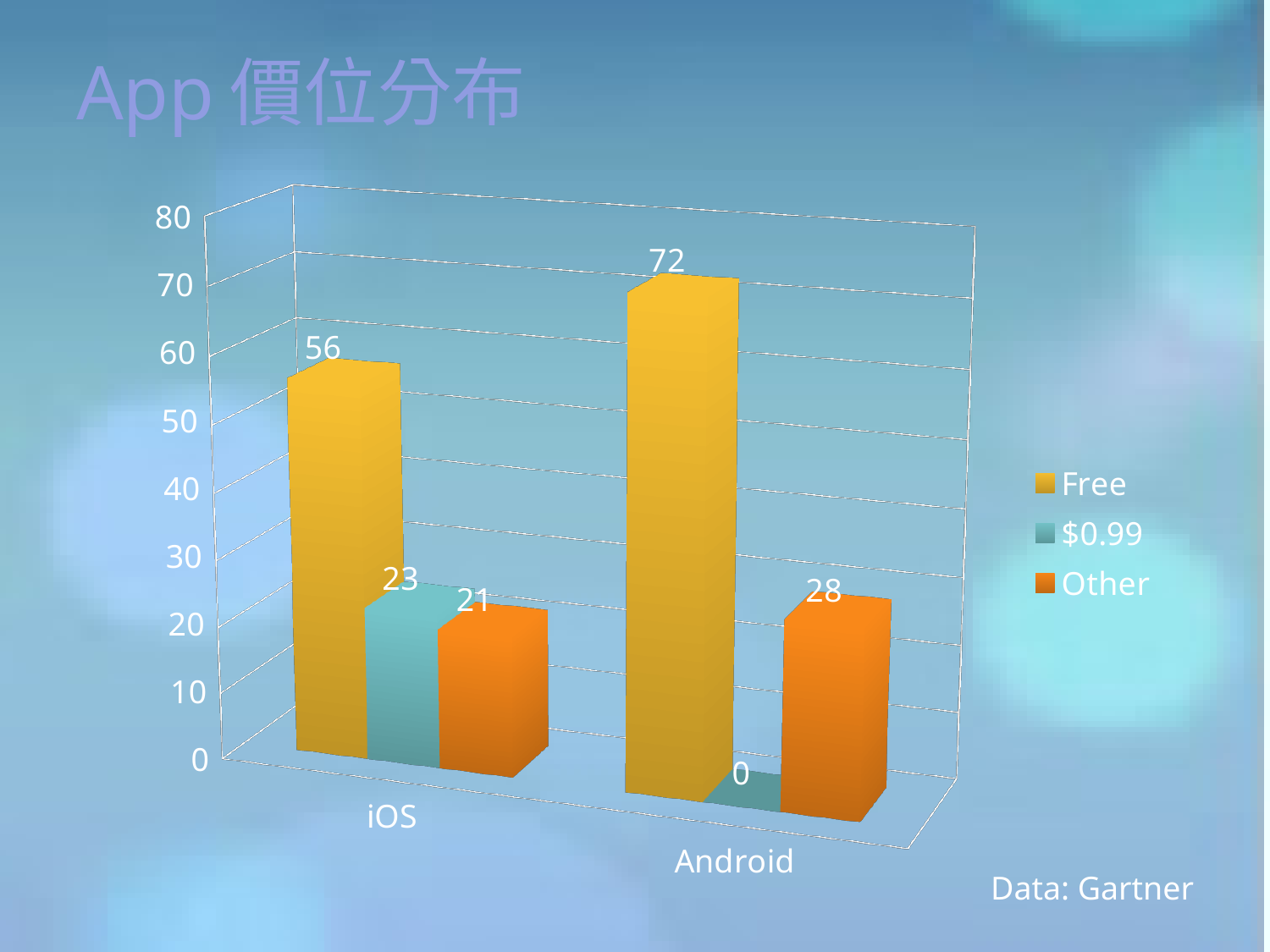
Which series has the lowest value on iOS? Other Which platform has the higher value for Free? Android What is the difference between the Other values for Android and iOS? 7 What is the value for $0.99 on iOS? 23 What kind of chart is shown on the slide? Bar chart What is the value for Free on Android? 72 What is the value for Free on iOS? 56 How many series does the legend list? 3 What is the difference between the Free values for Android and iOS? 16 How many categories are shown on the x axis? 2 What is the value for Other on Android? 28 What is the value for $0.99 on Android? 0